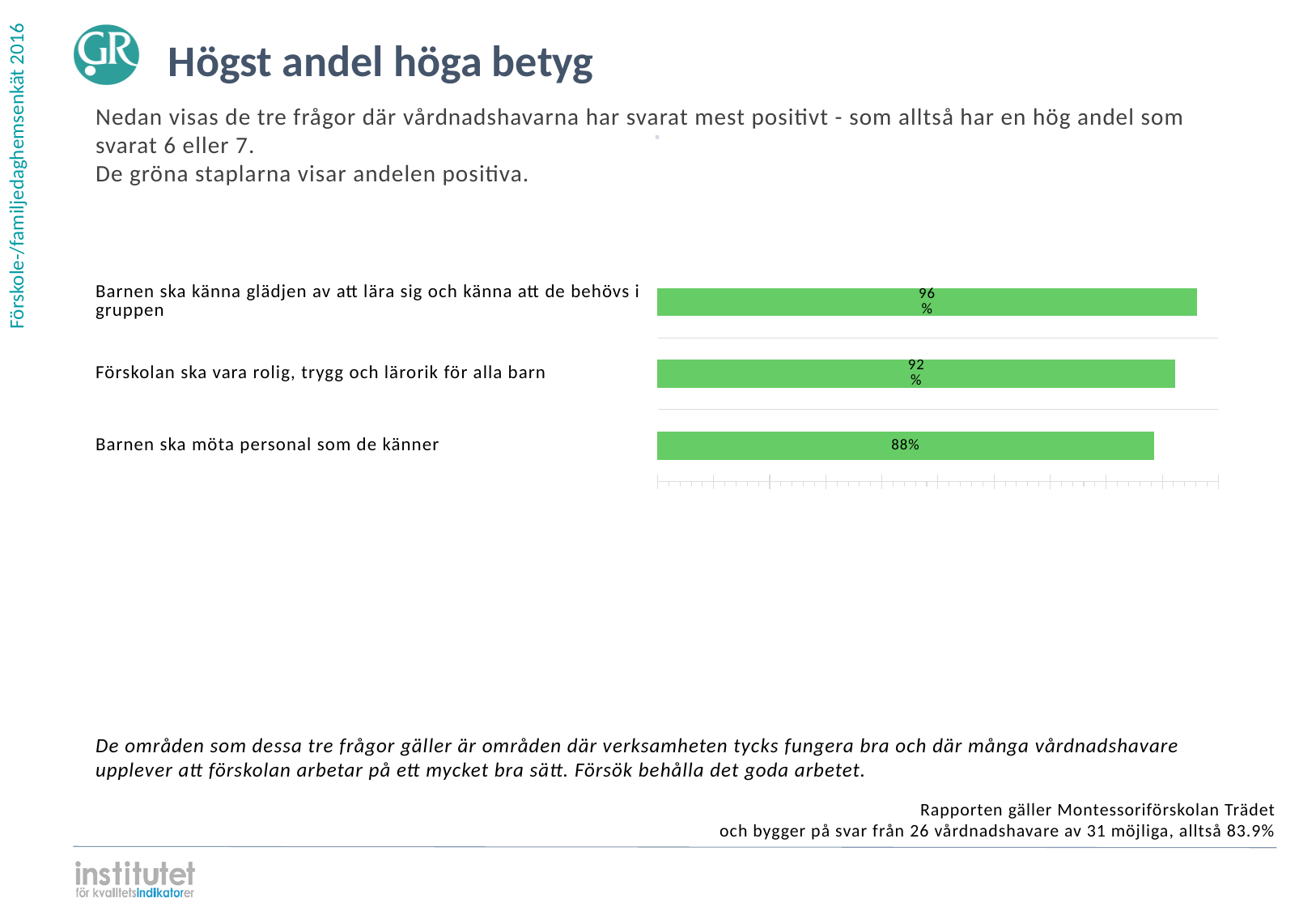
What kind of chart is shown on the slide? Bar chart Which is larger: the value for "Förskolan ska vara rolig, trygg och lärorik för alla barn" or for "Barnen ska möta personal som de känner"? Förskolan ska vara rolig, trygg och lärorik för alla barn How many categories are shown in the chart? 3 What is the difference between the values for "Barnen ska känna glädjen av att lära sig och känna att de behövs i gruppen" and "Barnen ska möta personal som de känner"? 8% Which category has the lowest value? Barnen ska möta personal som de känner What is the value for "Barnen ska känna glädjen av att lära sig och känna att de behövs i gruppen"? 96% What is the value for "Barnen ska möta personal som de känner"? 88% What is the value for "Förskolan ska vara rolig, trygg och lärorik för alla barn"? 92% What is the difference between the values for "Förskolan ska vara rolig, trygg och lärorik för alla barn" and "Barnen ska möta personal som de känner"? 4% Which category has the highest value? Barnen ska känna glädjen av att lära sig och känna att de behövs i gruppen What is the title of the slide containing the chart? Högst andel höga betyg What colour are the bars in the chart? Green